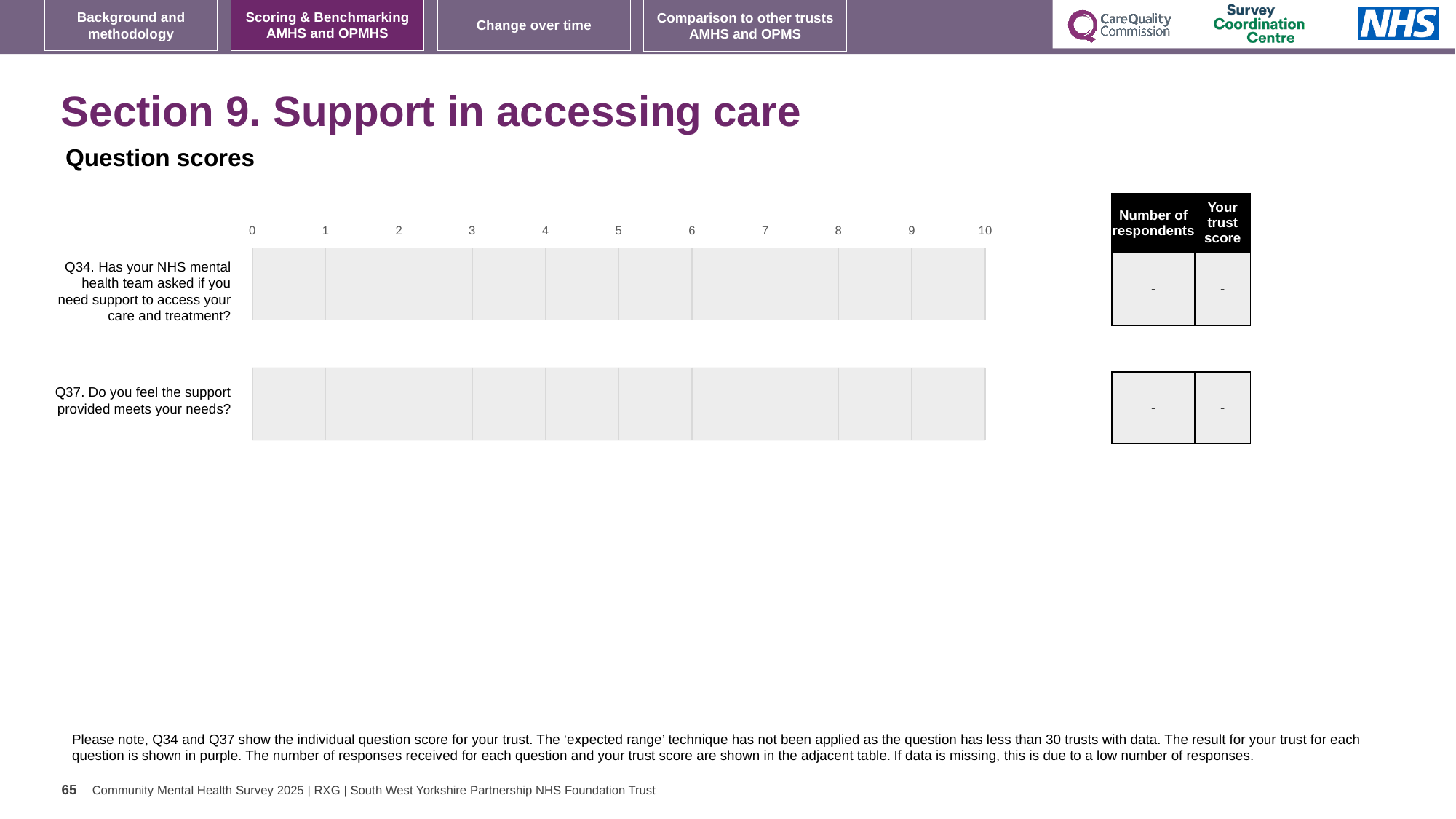
What kind of chart is shown on the slide? bar chart What is the heading above the chart? Question scores What is shown in the table as the number of respondents for Q34? - What is shown in the table as your trust score for Q37? - What is the highest value shown on the chart's x axis? 10 How many questions (categories) are listed on the chart? 2